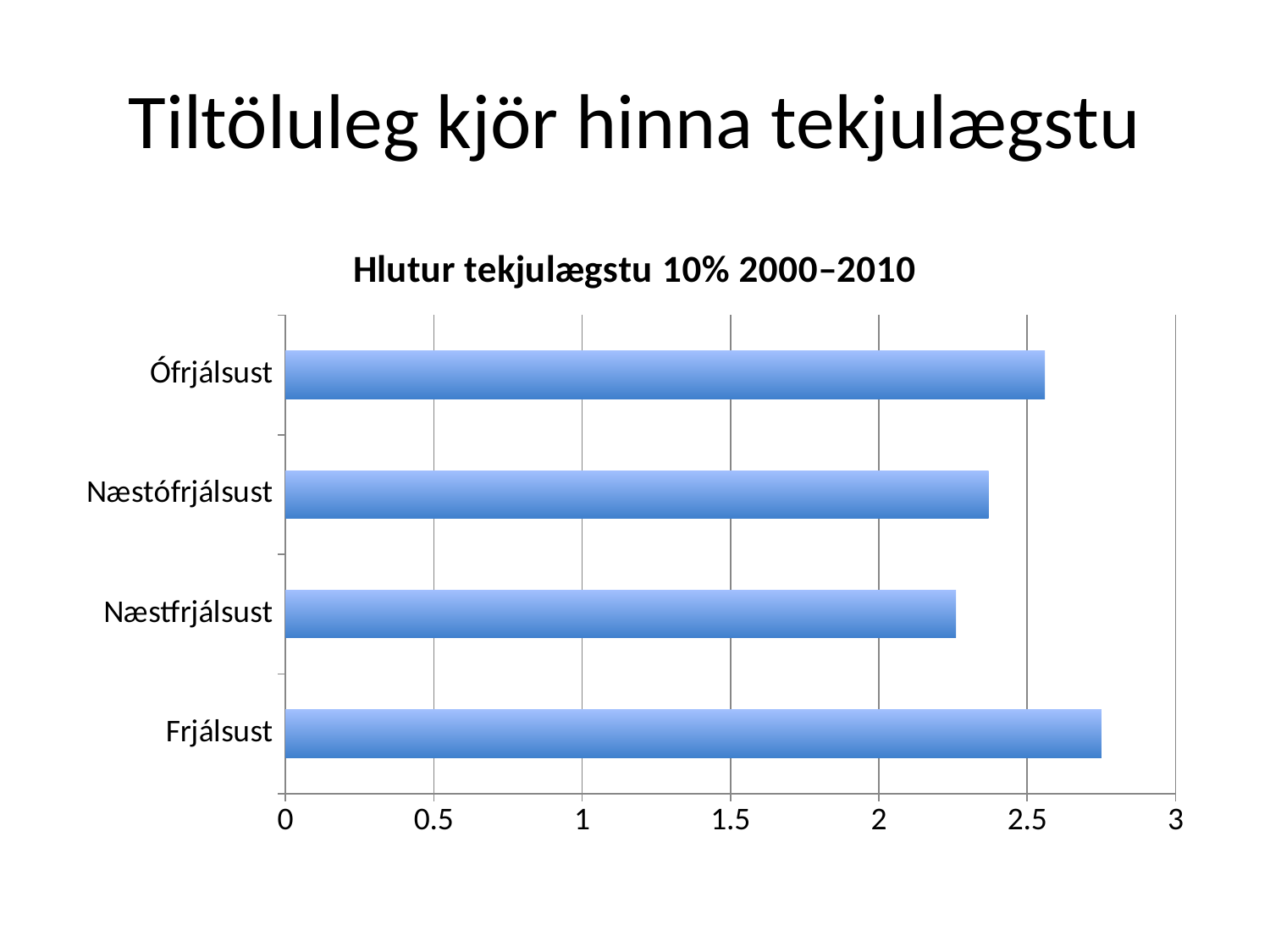
What is the highest value shown on the horizontal axis? 3 Which is larger, the value for Frjálsust or the value for Næstfrjálsust? Frjálsust How many categories are plotted in the chart? 4 What kind of chart is shown on the slide? bar chart Is the value for Ófrjálsust greater or less than 3? less Is the value for Næstfrjálsust greater or less than 2.5? less Which is larger, the value for Ófrjálsust or the value for Næstófrjálsust? Ófrjálsust Which category has the highest value? Frjálsust Is the value for Næstófrjálsust greater or less than 2? greater Which category has the lowest value? Næstfrjálsust What is the title of the chart? Hlutur tekjulægstu 10% 2000–2010